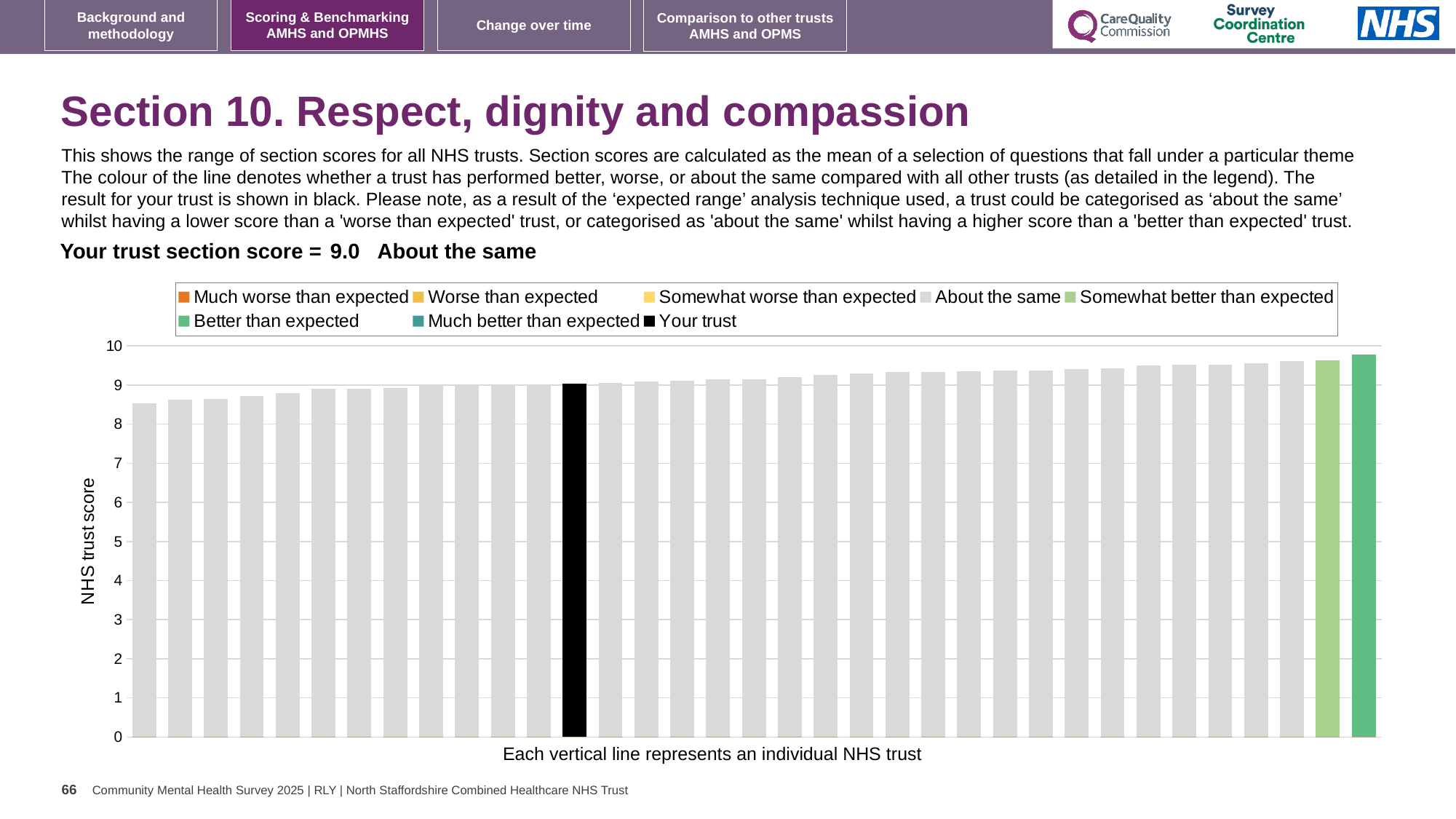
Is the value of the black 'Your trust' bar greater or less than 8? greater Is the value of the rightmost (highest) bar greater or less than 10? less Do the bar values rise or fall from left to right along the x axis? rise What kind of chart is shown on the slide? bar chart What is the label on the vertical axis of the chart? NHS trust score How many bars in the chart are coloured green rather than grey or black? 2 What is the section score for your trust shown on the slide? 9.0 What category is your trust's section score placed in, according to the text above the chart? About the same Which is larger, the rightmost bar or the black 'Your trust' bar? the rightmost bar Is the value of the leftmost bar greater or less than 9? less How many entries does the chart legend list? 8